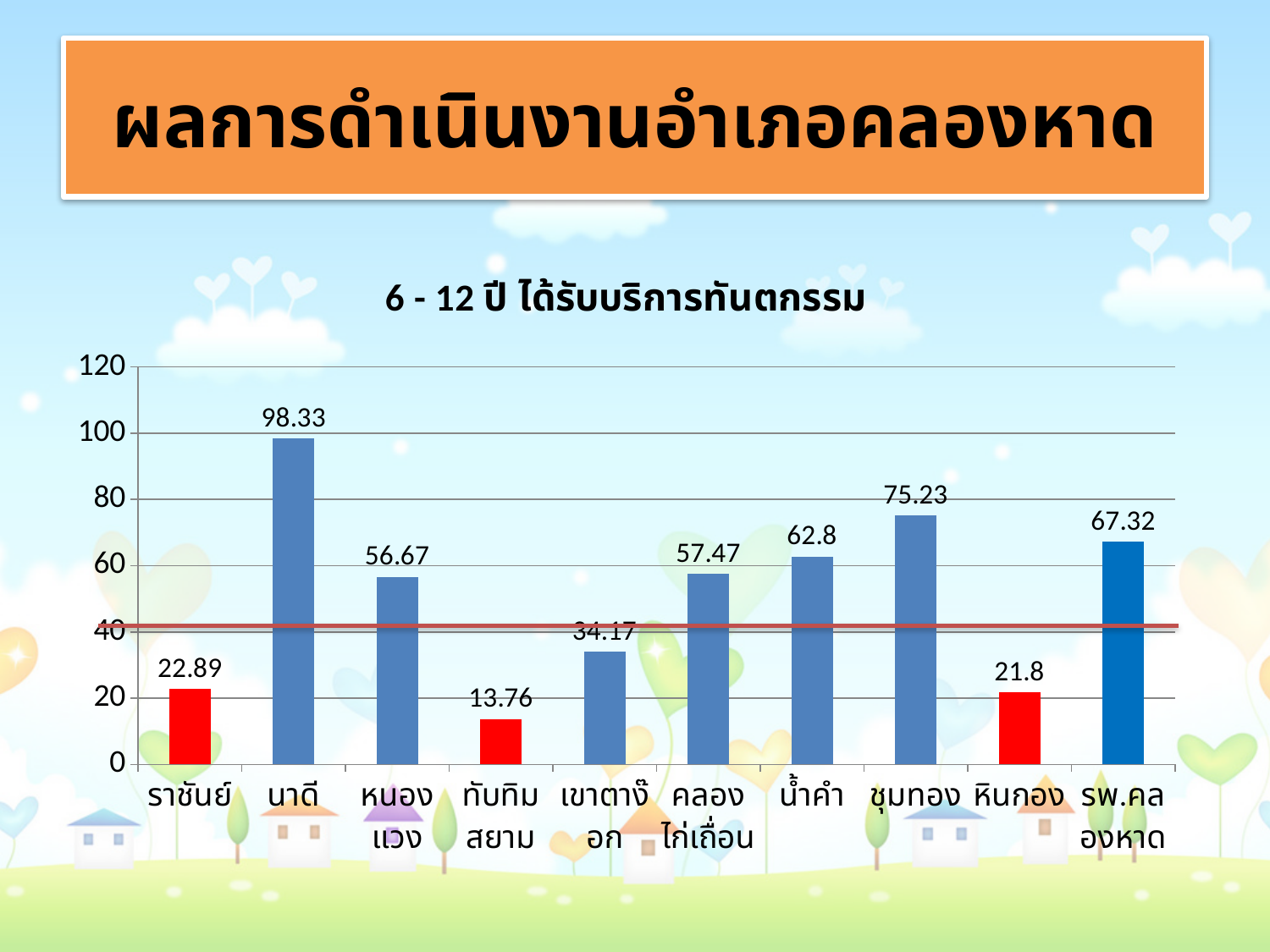
What is the value for ทับทิมสยาม? 13.76 What is the value for รพ.คลองหาด? 67.32 How many categories are shown on the x axis? 10 Which category has the lowest value? ทับทิมสยาม What is the value for นาดี? 98.33 Which is larger, the value for หนองแวง or the value for คลองไก่เถื่อน? คลองไก่เถื่อน Which category has the highest value? นาดี What is the title of the chart? 6 - 12 ปี ได้รับบริการทันตกรรม What is the value for หินกอง? 21.8 Is the value for เขาตางอก greater or less than 40? less What kind of chart is shown on the slide? bar chart What is the difference between the values for ชุมทอง and น้ำคำ? 12.43